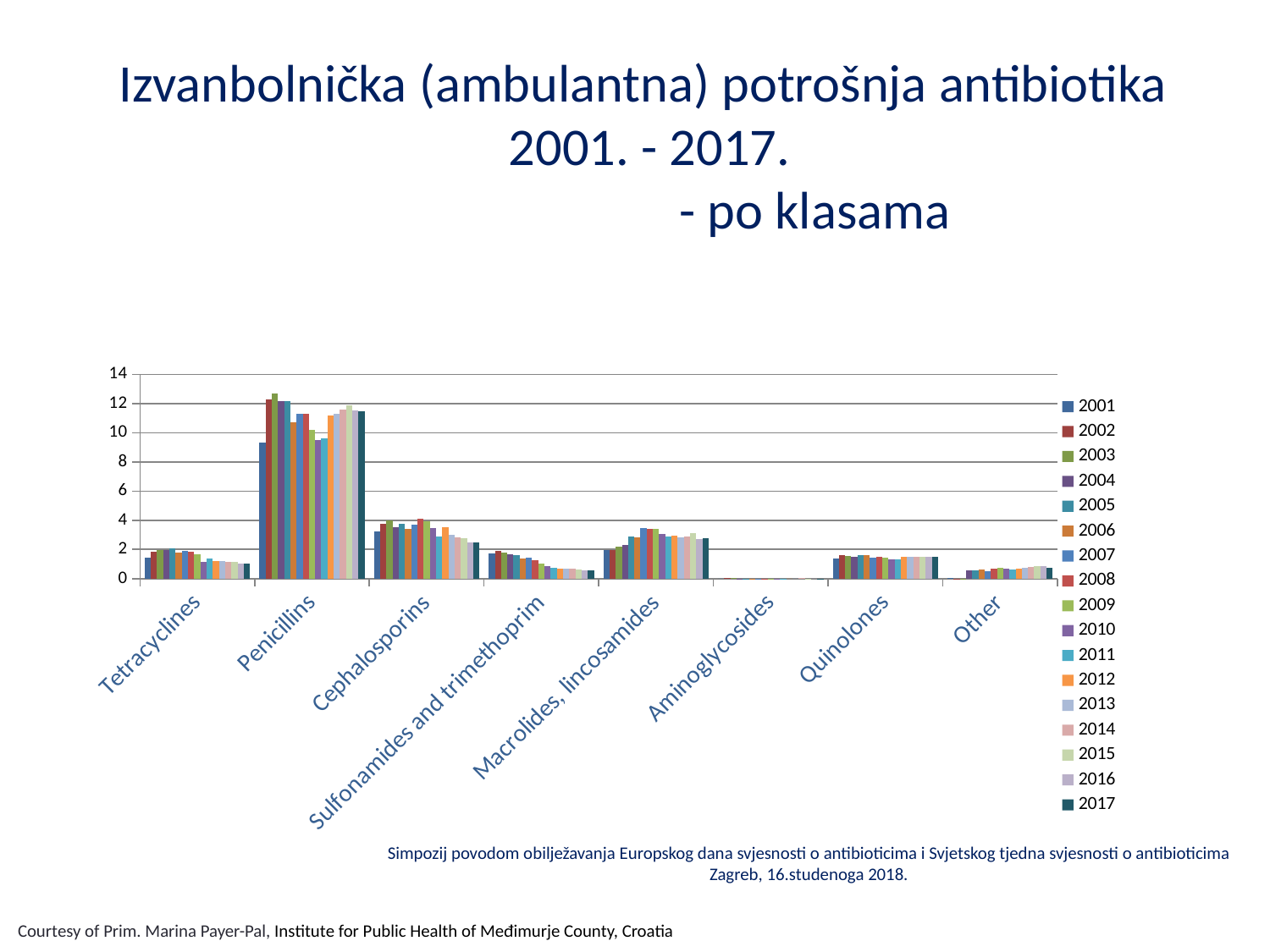
Do the values for Sulfonamides and trimethoprim rise or fall from 2001 to 2017? fall Which year is the first entry in the legend? 2001 Is the value for Penicillins in 2003 greater or less than 12? greater Is the value for Tetracyclines in 2001 greater or less than 2? less Is the value for Penicillins in 2001 greater or less than 10? less Which is larger in 2001: the value for Cephalosporins or the value for Macrolides, lincosamides? Cephalosporins Which antibiotic class has the lowest values in the chart? Aminoglycosides What kind of chart is shown on the slide? bar chart Which antibiotic class has the highest values in the chart? Penicillins How many antibiotic classes (categories) are shown on the x axis? 8 How many series (years) does the legend list? 17